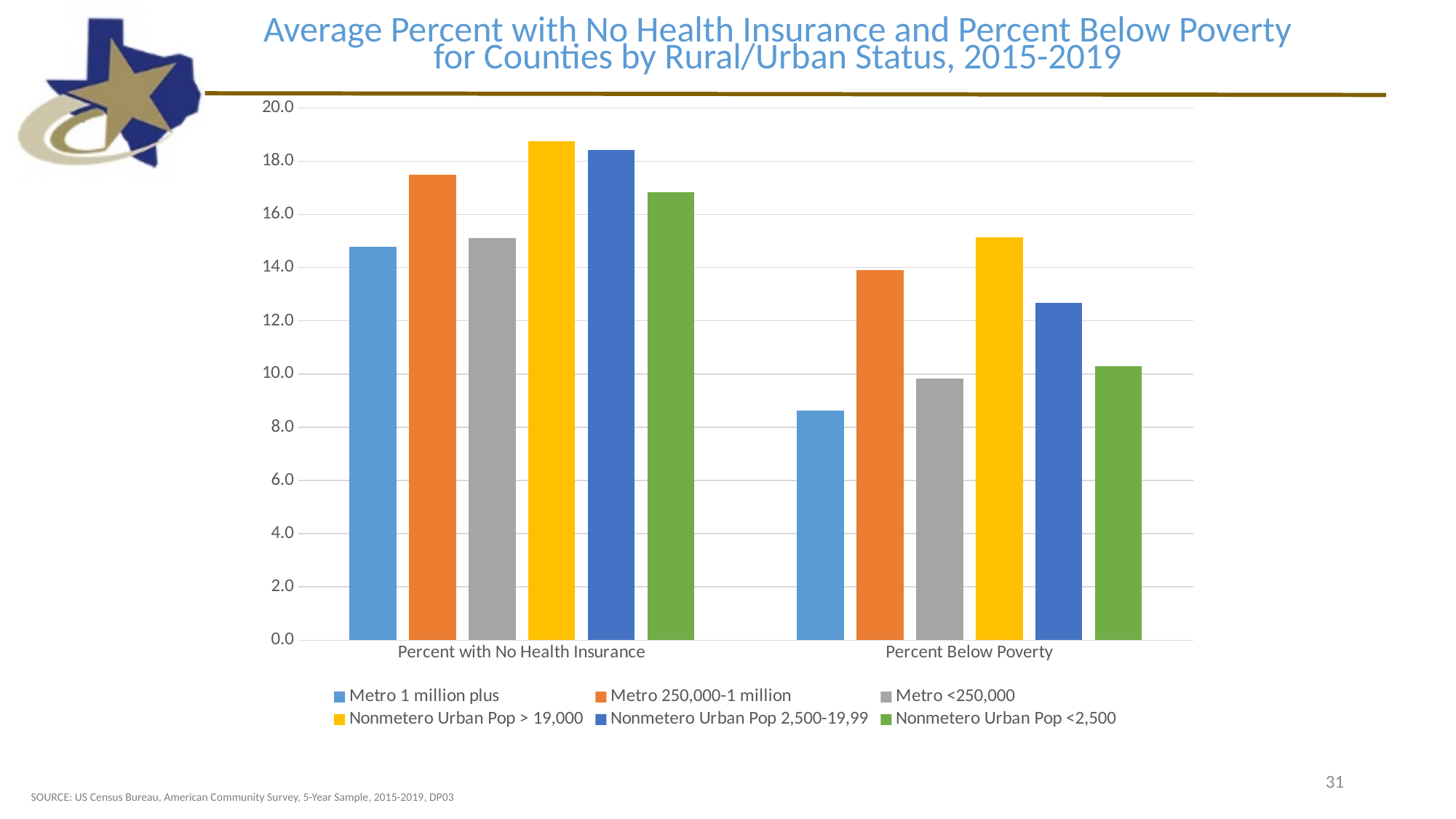
How many series does the legend list? 6 Which series has the lowest value for Percent Below Poverty? Metro 1 million plus How many categories are shown on the x axis? 2 What colour represents Metro 1 million plus in the legend? blue For Percent Below Poverty, which is larger: Metro 250,000-1 million or Metro <250,000? Metro 250,000-1 million Is the value for Nonmetero Urban Pop 2,500-19,99 in Percent Below Poverty greater or less than 12.0? greater Is the value for Nonmetero Urban Pop > 19,000 in Percent with No Health Insurance greater or less than 18.0? greater Is the value for Metro 1 million plus in Percent Below Poverty greater or less than 10.0? less For Nonmetero Urban Pop <2,500, which is larger: Percent with No Health Insurance or Percent Below Poverty? Percent with No Health Insurance What kind of chart is shown on the slide? bar chart Which series has the highest value for Percent Below Poverty? Nonmetero Urban Pop > 19,000